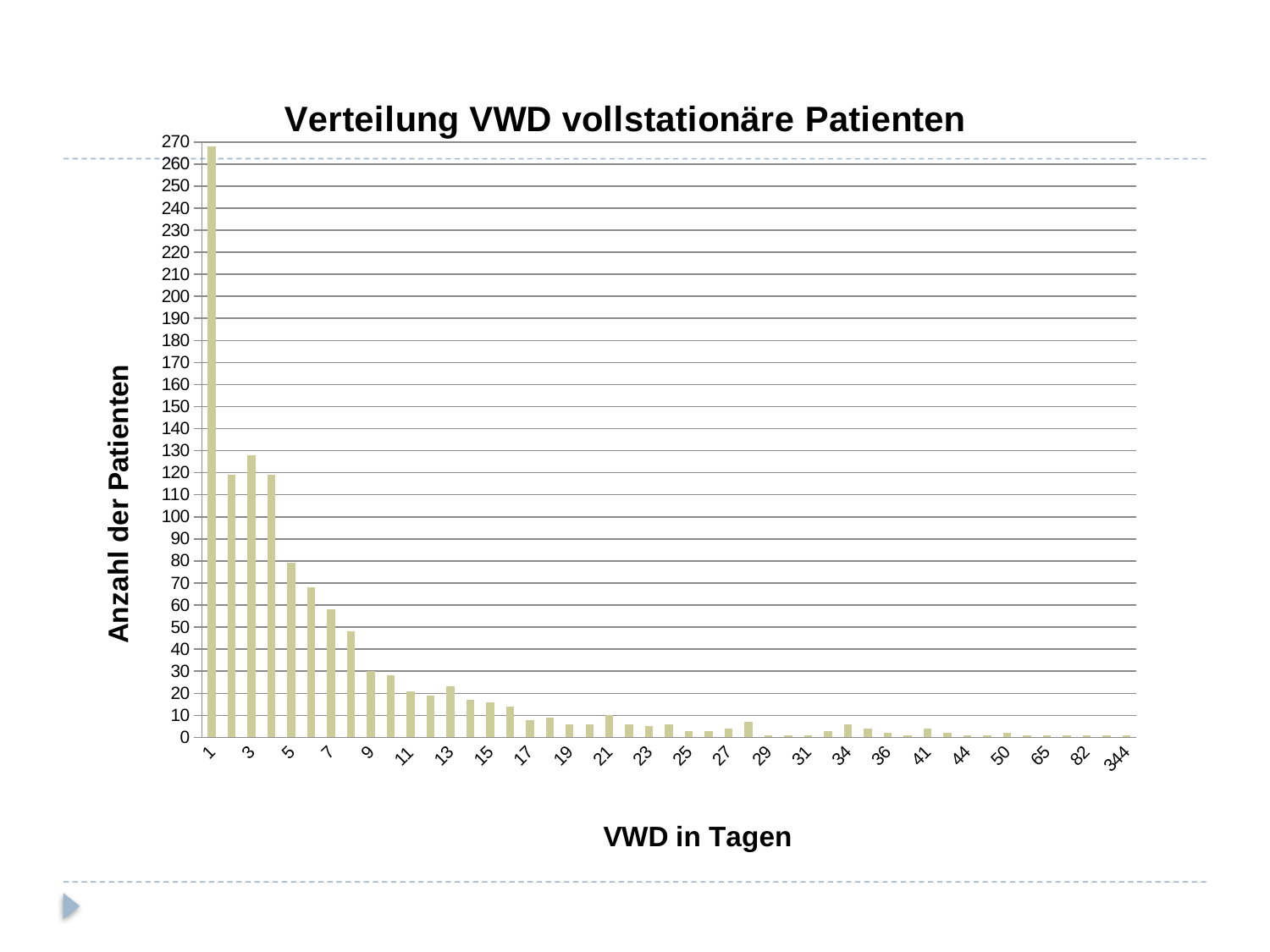
Which has more patients, VWD 1 or VWD 3? 1 What is the label of the y axis? Anzahl der Patienten Is the value for VWD 1 greater or less than 250? greater Is the value for VWD 9 greater or less than 40? less What kind of chart is shown on the slide? bar chart Is the value for VWD 17 greater or less than 20? less Do the values generally rise or fall as VWD in Tagen increases along the x axis? fall Which VWD category has the highest number of patients? 1 What is the title of the chart? Verteilung VWD vollstationäre Patienten